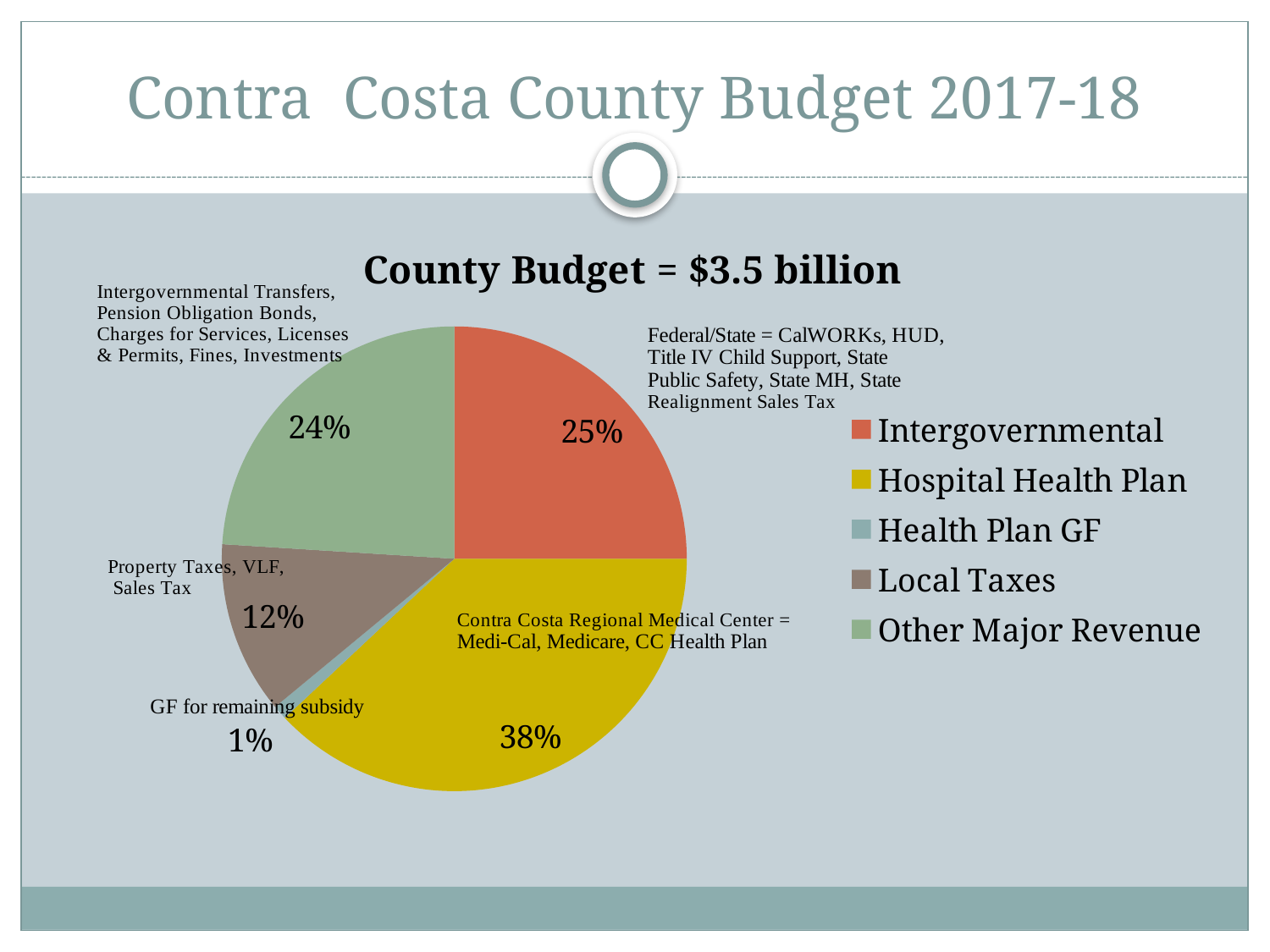
What share of the pie does Local Taxes represent? 12% What is the difference in percentage points between Hospital Health Plan and Intergovernmental? 13 What share of the pie does Health Plan GF represent? 1% Which category has the smallest slice of the pie? Health Plan GF What share of the pie does Other Major Revenue represent? 24% What kind of chart is shown on the slide? Pie chart How many categories does the pie chart show? 5 Which is larger, the Intergovernmental slice or the Other Major Revenue slice? Intergovernmental Which category has the largest slice of the pie? Hospital Health Plan What is the title of the chart? County Budget = $3.5 billion